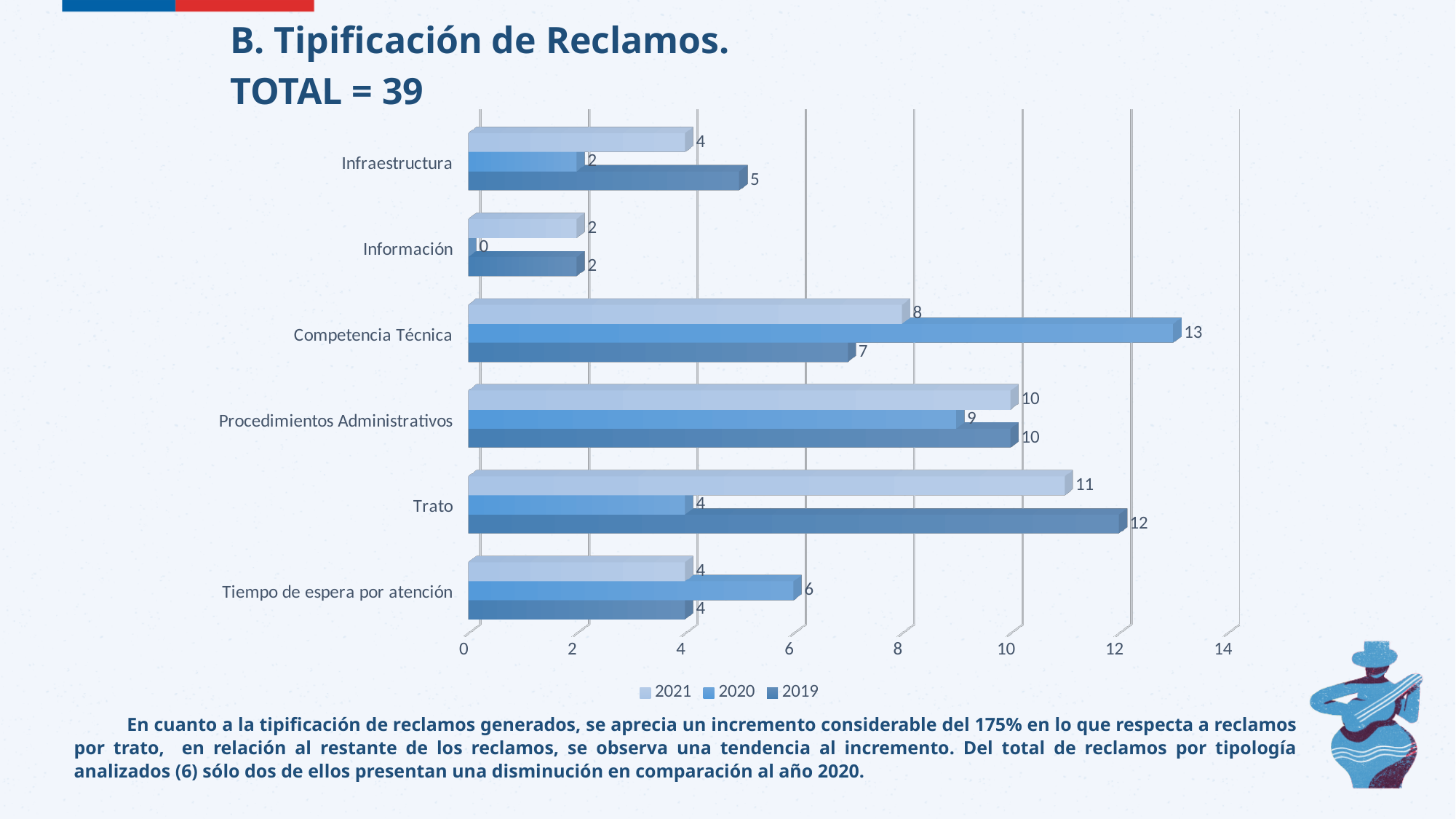
What kind of chart is shown on the slide? Bar chart What is the difference between the 2021 and 2020 values for Trato? 7 What is the value for Trato in 2019? 12 How many series does the legend list? 3 What total is stated in the chart title? 39 Which category has the highest value for the 2021 series? Trato Which is larger for Tiempo de espera por atención: the 2020 value or the 2019 value? 2020 What is the value for Competencia Técnica in 2020? 13 Which category has the lowest value for the 2019 series? Información What is the total of the three series values for Infraestructura? 11 What is the value for Información in 2020? 0 How many categories are shown on the chart? 6